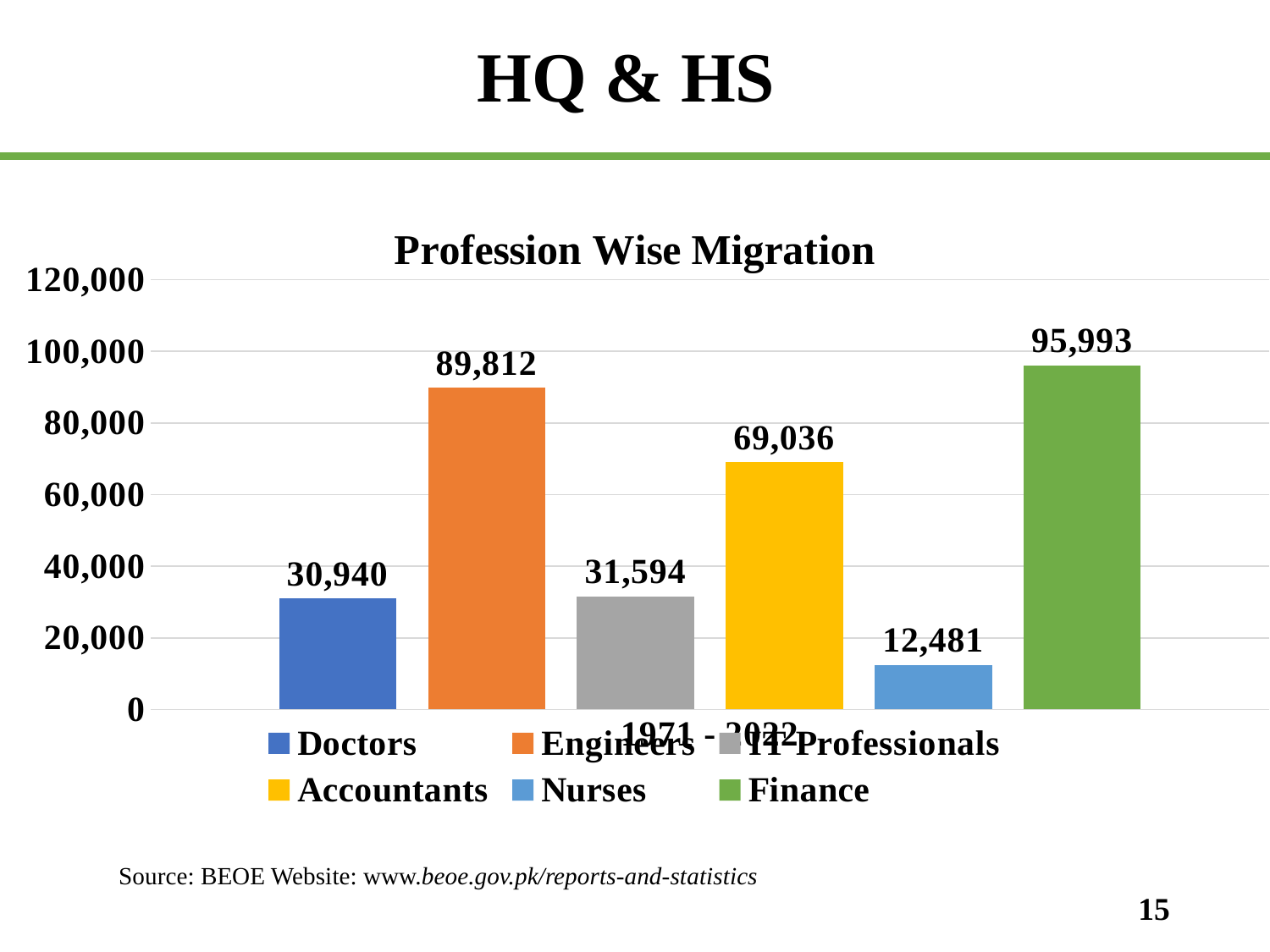
What is the value for Accountants in the Profession Wise Migration chart? 69,036 What is the difference between the Finance value and the Engineers value? 6,181 How many bars are plotted in the Profession Wise Migration chart? 6 What is the value for Engineers in the Profession Wise Migration chart? 89,812 Which profession has the lowest migration value in the chart? Nurses What kind of chart is shown on the slide? bar chart What is the value for Nurses in the Profession Wise Migration chart? 12,481 Is the value for Doctors greater or less than 40,000? less How many entries does the legend of the chart list? 6 Which profession has the highest migration value in the chart? Finance What is the difference between the Accountants value and the Nurses value? 56,555 Which is larger, the value for Doctors or the value for Accountants? Accountants